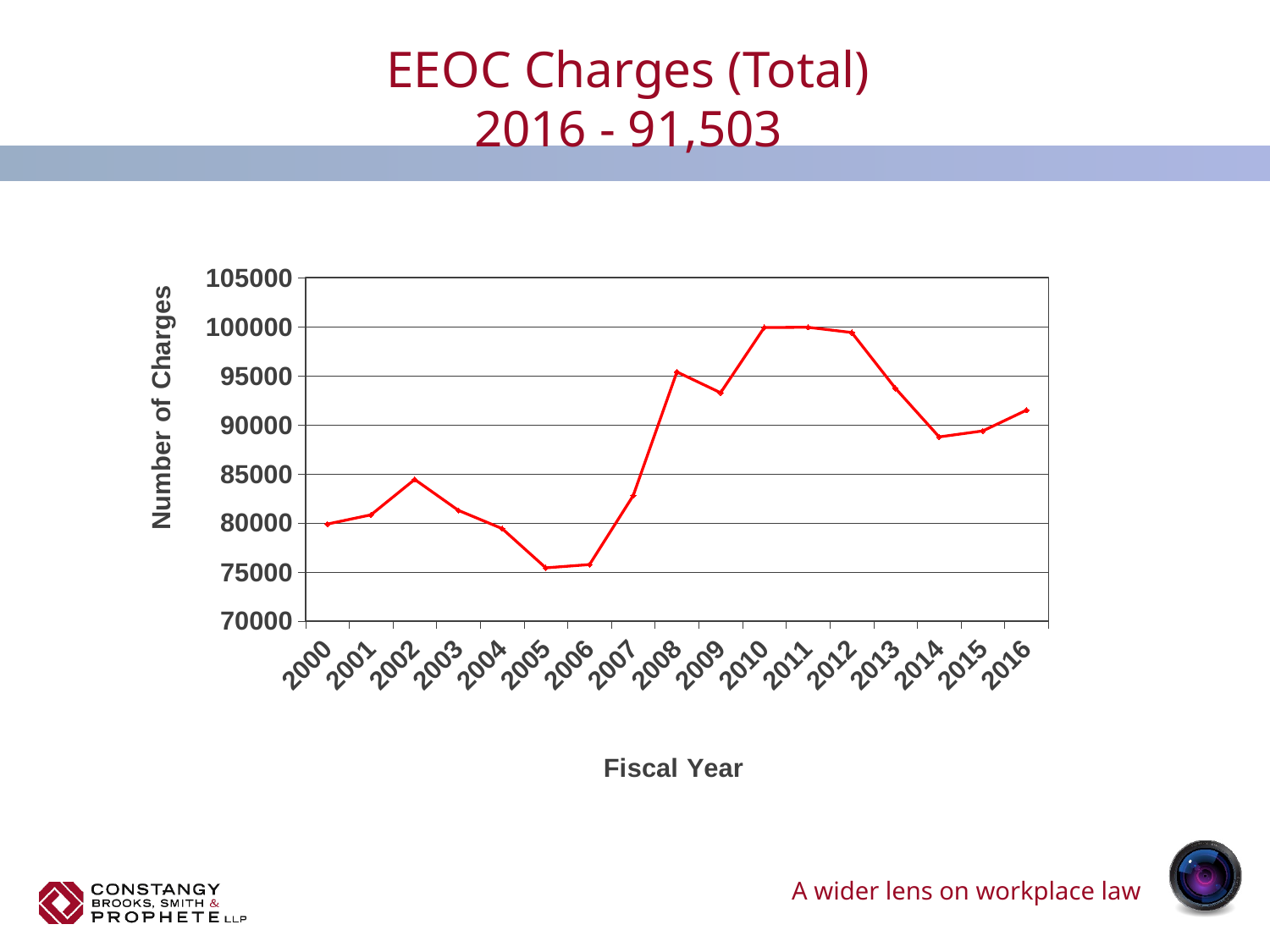
Is the value for 2014 greater or less than 90000? less Is the value for 2008 greater or less than 90000? greater What is the label of the y axis? Number of Charges Which year has the larger number of charges, 2008 or 2002? 2008 What kind of chart is shown on the slide? Line chart Do the values rise or fall from 2011 to 2014? Fall According to the slide title, what was the total number of EEOC charges in 2016? 91,503 Which year has the larger number of charges, 2012 or 2014? 2012 Is the value for 2010 greater or less than 95000? greater How many fiscal years are plotted on the x axis? 17